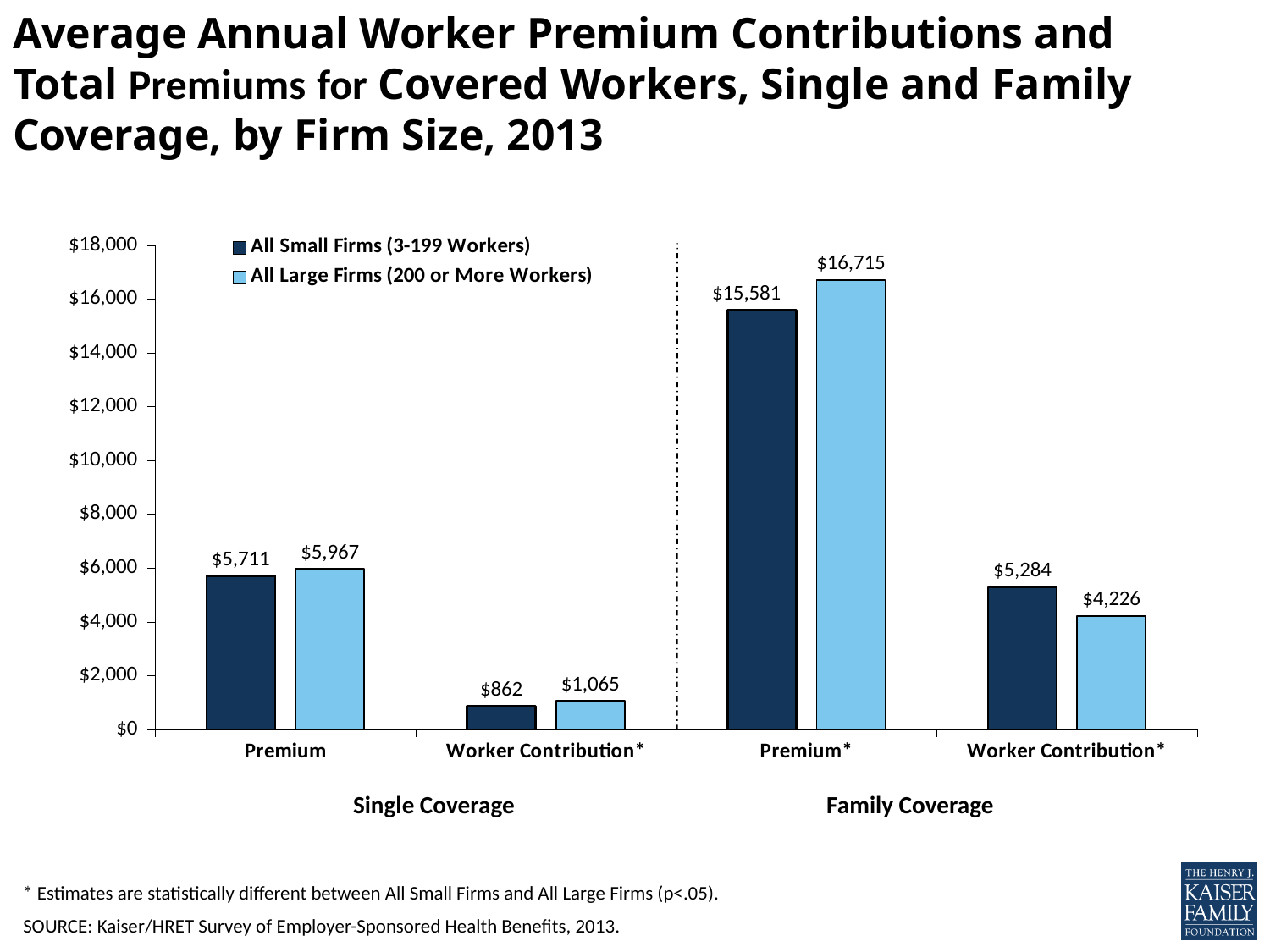
What is the worker contribution for family coverage at All Large Firms (200 or More Workers)? $4,226 What is the difference between the single coverage worker contribution for All Large Firms and All Small Firms? $203 Which bar on the chart has the highest value? Family Coverage Premium*, All Large Firms (200 or More Workers) What is the difference between the family coverage premium for All Large Firms and All Small Firms? $1,134 What kind of chart is shown on the slide? Bar chart What is the worker contribution for single coverage at All Small Firms (3-199 Workers)? $862 How many series does the legend list? 2 For family coverage worker contribution, which is larger: All Small Firms or All Large Firms? All Small Firms Which bar on the chart has the lowest value? Single Coverage Worker Contribution*, All Small Firms (3-199 Workers) What is the average annual premium for family coverage at All Large Firms (200 or More Workers)? $16,715 Is the family coverage premium for All Small Firms greater or less than $14,000? greater What is the average annual premium for single coverage at All Small Firms (3-199 Workers)? $5,711